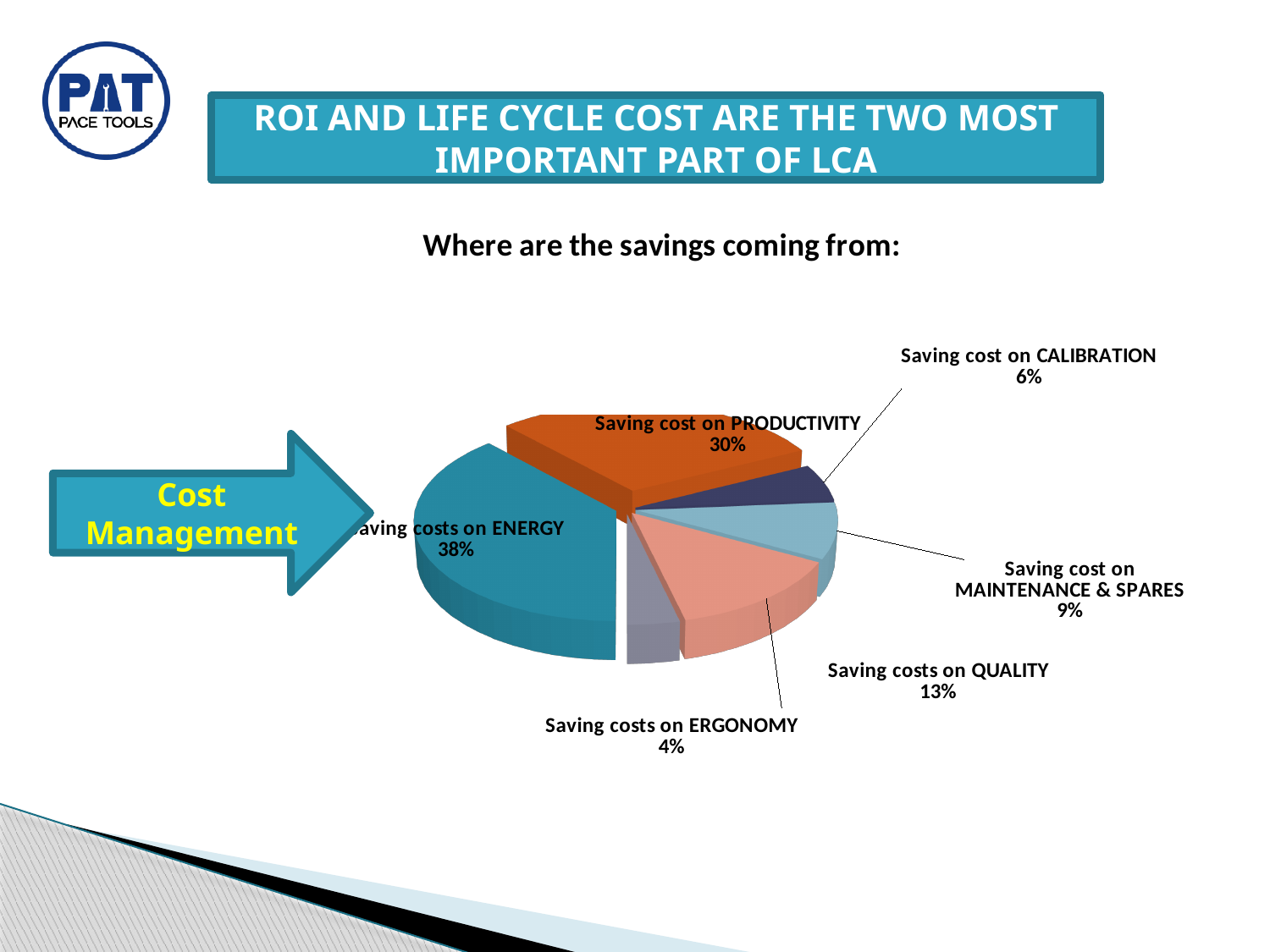
What share of savings comes from Saving cost on MAINTENANCE & SPARES? 9% Which category accounts for the smallest share of savings? Saving costs on ERGONOMY What share of savings comes from Saving costs on QUALITY? 13% How many slices does the pie chart have? 6 What share of savings comes from Saving costs on ERGONOMY? 4% What is the difference in percentage points between Saving costs on ENERGY and Saving cost on PRODUCTIVITY? 8% Which is larger, the share for Saving costs on QUALITY or the share for Saving cost on MAINTENANCE & SPARES? Saving costs on QUALITY Which category accounts for the largest share of savings? Saving costs on ENERGY What kind of chart is shown on the slide? pie chart